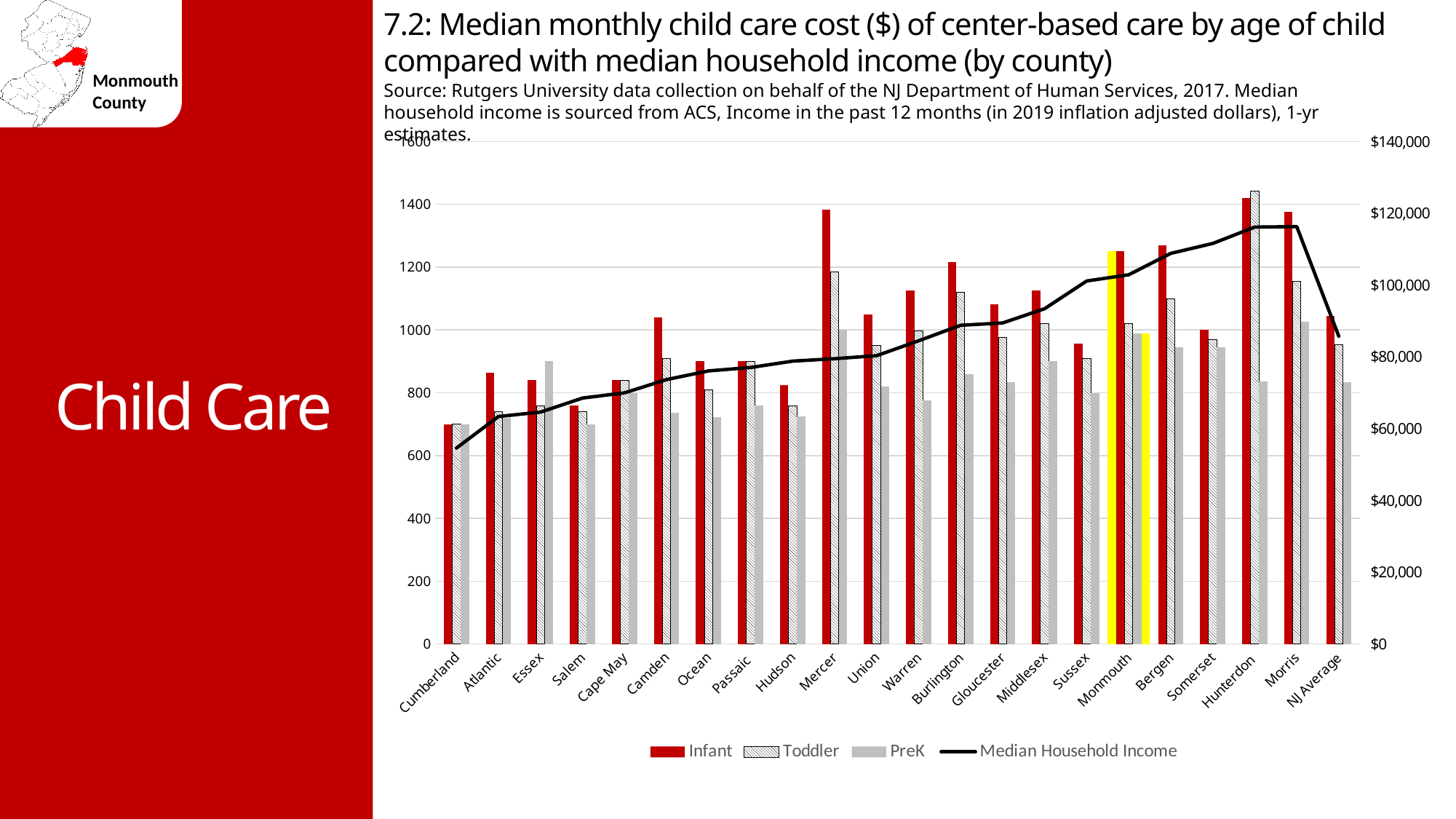
Which county has the highest Infant child care cost? Hunterdon Does the Median Household Income line generally rise or fall from Cumberland to Morris? rise Is the Infant cost for Mercer greater or less than 1200? greater Which county's bars are highlighted in yellow on the chart? Monmouth Which is larger for Mercer, the Infant cost or the Toddler cost? Infant Which county has the lowest Infant child care cost? Cumberland How many series does the chart legend list? 4 Which county has the highest Toddler child care cost? Hunterdon Is the Median Household Income for Morris greater or less than $100,000? greater How many counties/categories are shown on the x axis of the chart? 22 What kind of chart is used to show the child care costs by age of child? Bar chart (with a line for Median Household Income) Is the Infant cost for Cumberland greater or less than 800? less